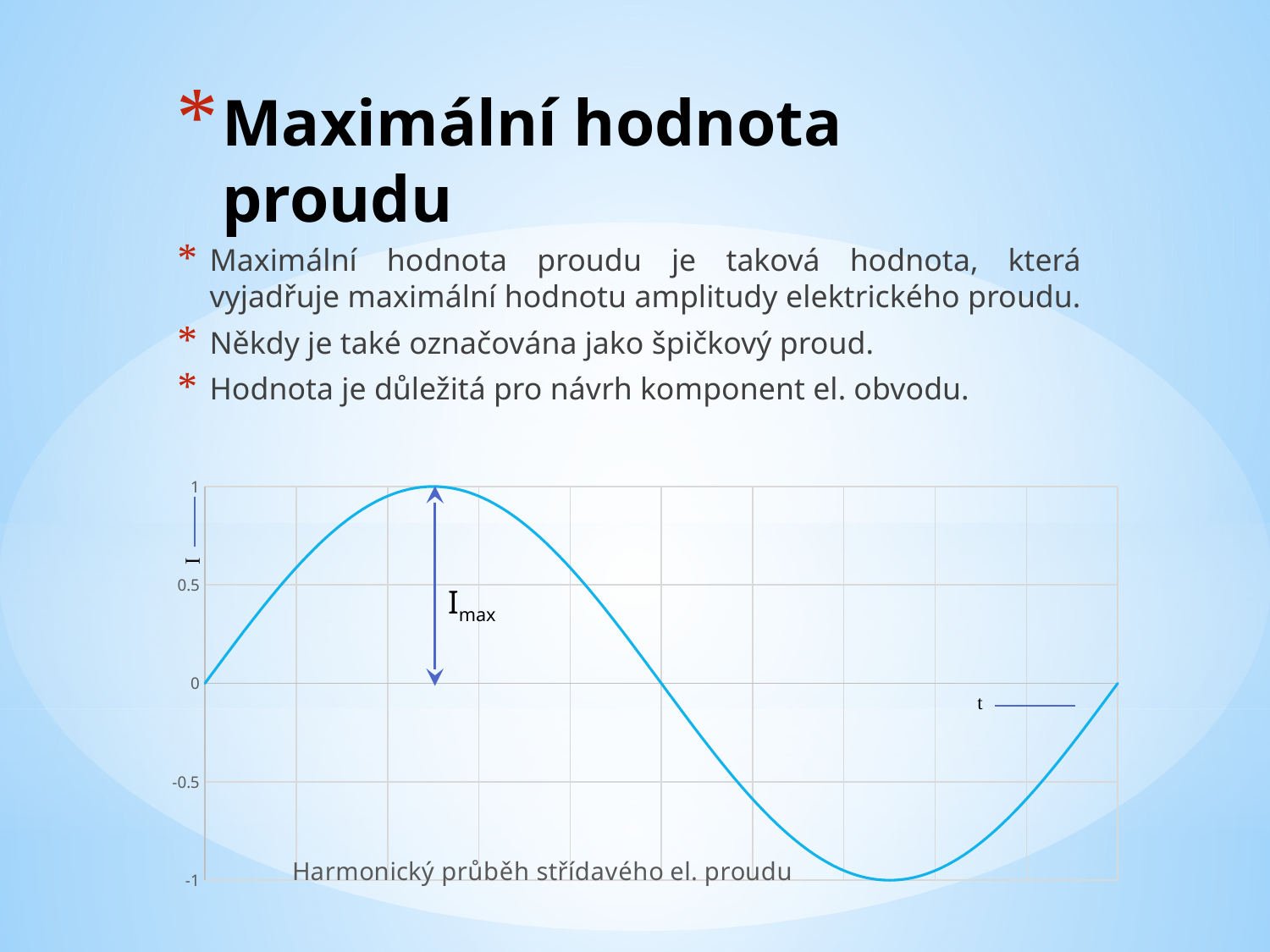
What value does the curve start at on the left edge of the chart? 0 What label is shown on the vertical axis of the chart? I What kind of chart is shown on the slide? line chart What is the highest value reached by the curve on the chart? 1 Is the value of the curve at its trough greater or less than -0.5? less What is the lowest value reached by the curve on the chart? -1 Does the curve rise or fall between its peak and its trough? fall Does the curve rise or fall from the left edge of the chart to its first peak? rise What value does the curve end at on the right edge of the chart? 0 What is the title of the chart? Harmonický průběh střídavého el. proudu What is the difference between the highest and lowest values of the curve? 2 Is the value of the curve at its peak greater or less than 0.5? greater